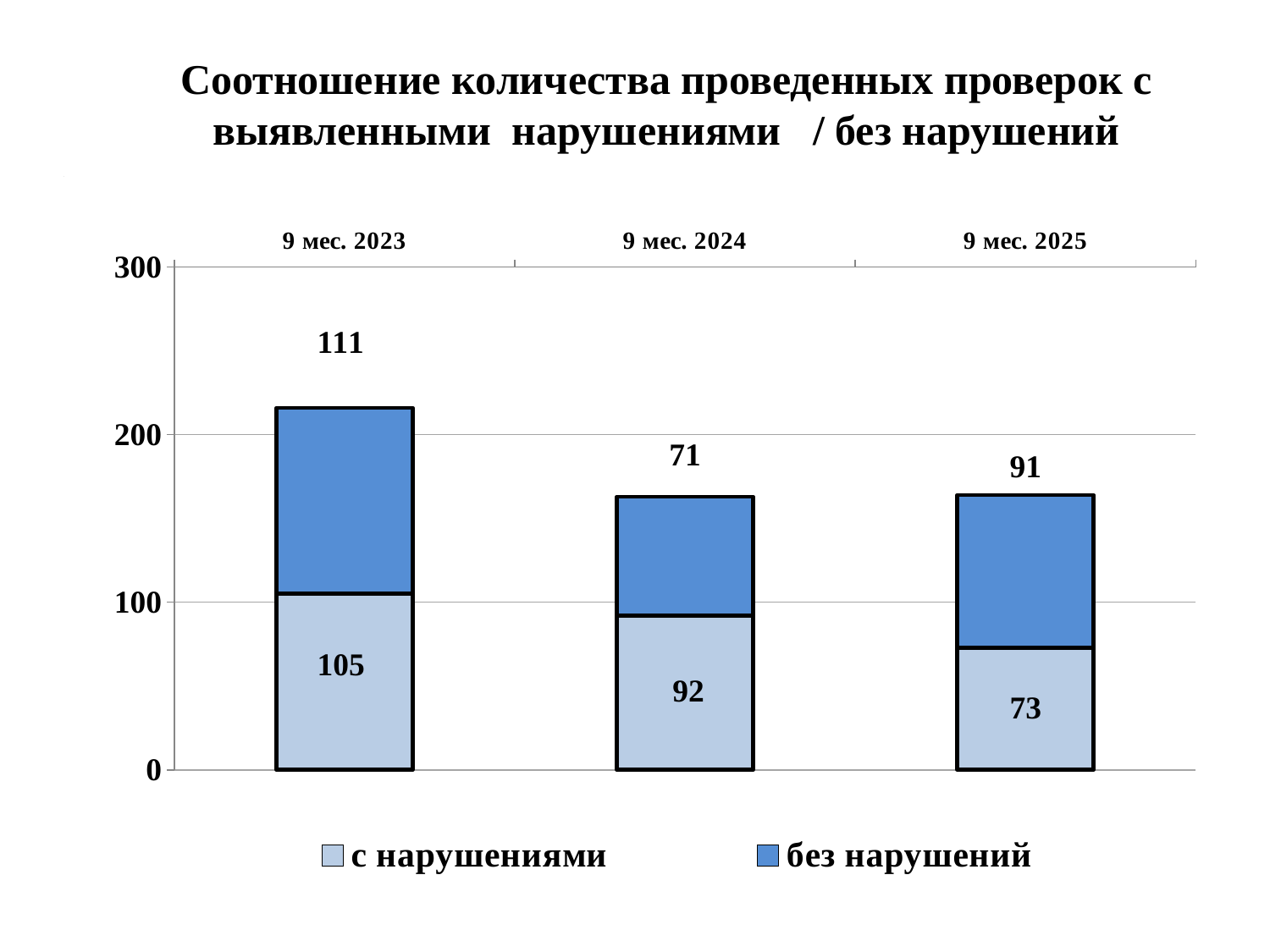
Which is larger in 9 мес. 2025: "с нарушениями" or "без нарушений"? без нарушений What is the value for "без нарушений" in 9 мес. 2025? 91 Which period has the lowest value for "без нарушений"? 9 мес. 2024 What is the value for "с нарушениями" in 9 мес. 2023? 105 What is the value for "без нарушений" in 9 мес. 2024? 71 Which period has the highest value for "с нарушениями"? 9 мес. 2023 What is the total of the stacked bar for 9 мес. 2023? 216 What is the value for "с нарушениями" in 9 мес. 2025? 73 What is the difference between the "с нарушениями" values for 9 мес. 2023 and 9 мес. 2025? 32 How many periods are shown on the x axis? 3 What kind of chart is shown on the slide? Stacked bar chart How many series does the legend list? 2